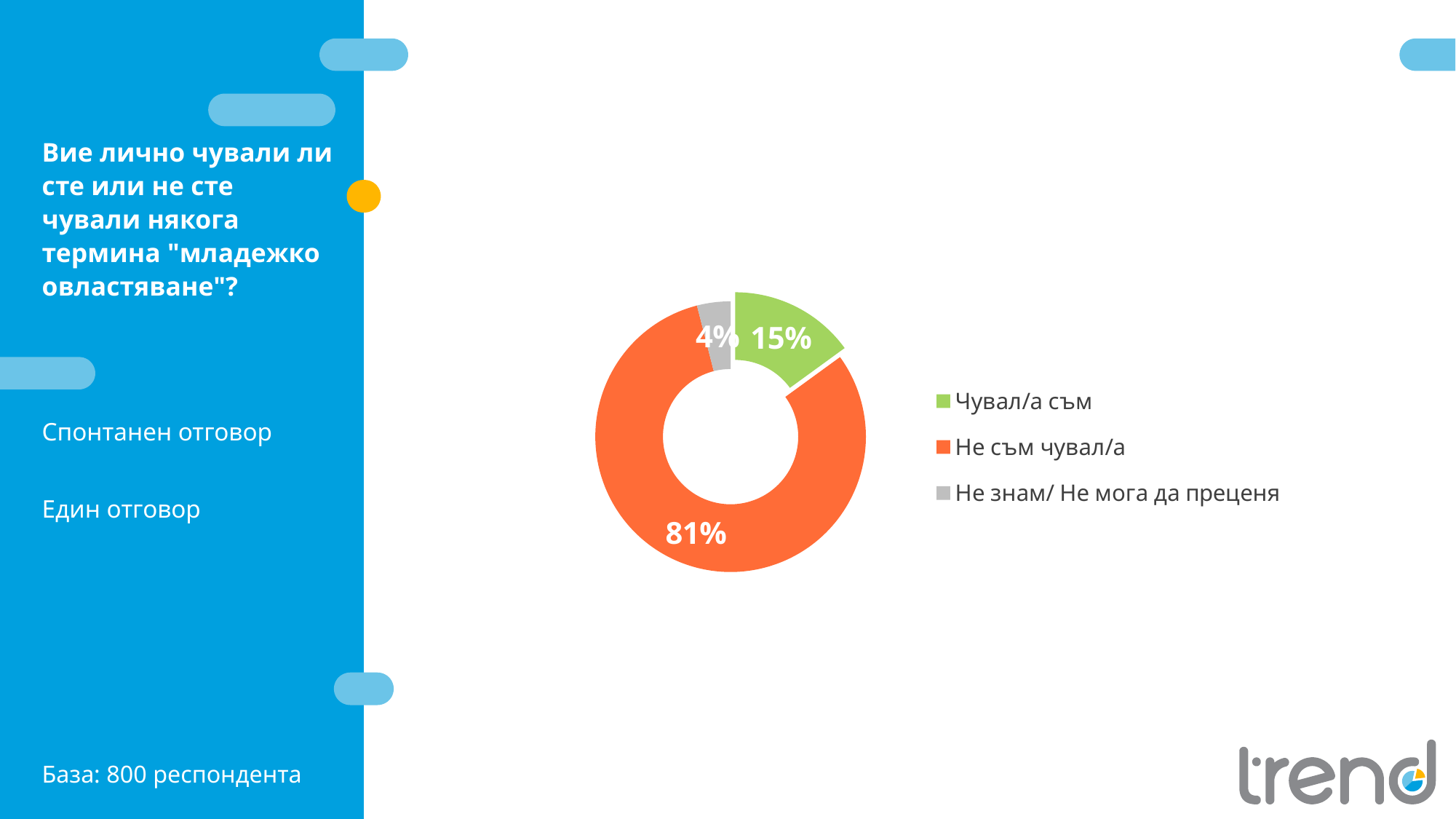
What kind of chart is shown on the slide? Doughnut (pie) chart Which is larger: the share for "Чувал/а съм" or the share for "Не знам/ Не мога да преценя"? Чувал/а съм How many respondents form the base of the survey shown on the slide? 800 What percentage of respondents answered "Чувал/а съм"? 15% What percentage of respondents answered "Не знам/ Не мога да преценя"? 4% Which answer category has the largest share of the chart? Не съм чувал/а Which answer category has the smallest share of the chart? Не знам/ Не мога да преценя How many entries does the legend list? 3 What percentage of respondents answered "Не съм чувал/а"? 81% How many answer categories are shown in the chart? 3 What is the difference in percentage points between "Не съм чувал/а" and "Чувал/а съм"? 66 What colour represents "Не съм чувал/а" in the chart? Orange